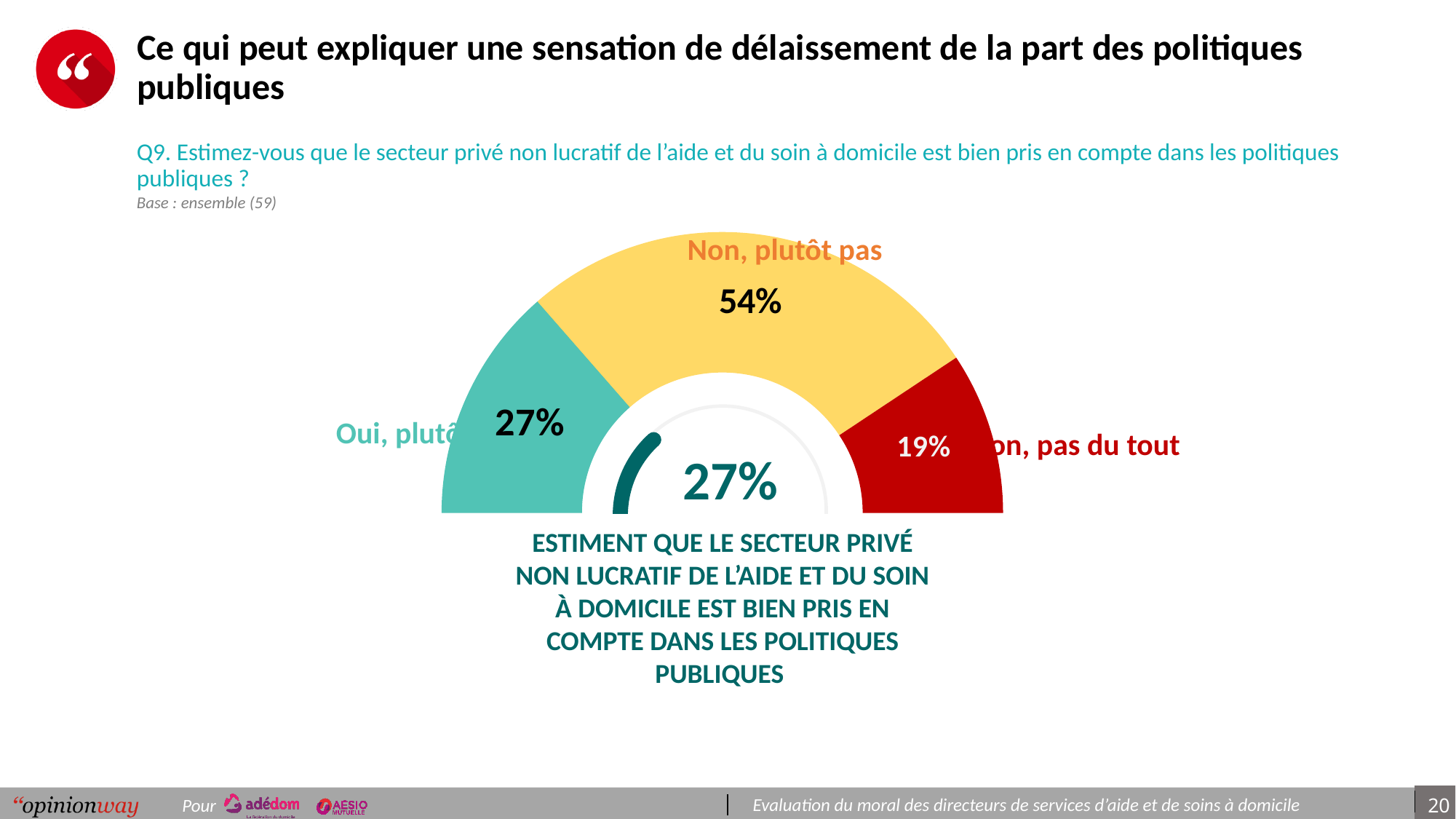
Which response category has the largest share? Non, plutôt pas What kind of chart is shown on the slide? Pie chart (half-donut / gauge) What do the three segments of the chart add up to? 100% What percentage of respondents answered "Oui, plutôt"? 27% What is the difference in percentage points between "Non, plutôt pas" and "Non, pas du tout"? 35 percentage points How many response categories are shown in the chart? 3 Which is larger, the share for "Oui, plutôt" or the share for "Non, pas du tout"? Oui, plutôt What colour is the "Non, plutôt pas" segment? Yellow What percentage of respondents answered "Non, plutôt pas"? 54% What is the difference in percentage points between "Non, plutôt pas" and "Oui, plutôt"? 27 percentage points Which response category has the smallest share? Non, pas du tout What percentage of respondents answered "Non, pas du tout"? 19%